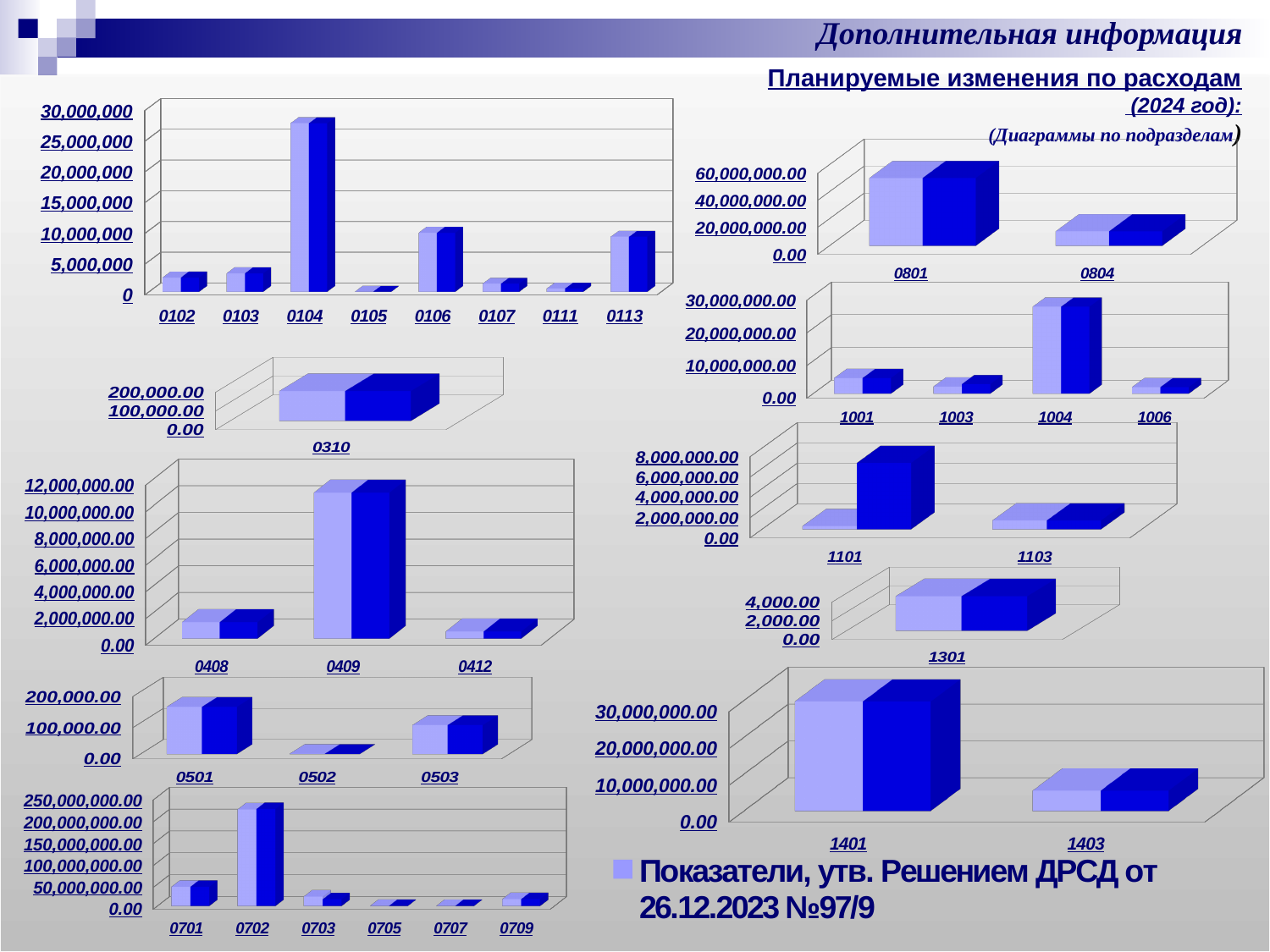
In the chart with categories 1001 to 1006, which category has the highest value? 1004 In the top-left chart (categories 0102 to 0113), which category has the highest value? 0104 In the chart with categories 0701 to 0709, is the value for 0702 greater or less than 200,000,000.00? greater In the chart with categories 0501, 0502 and 0503, which category has the lowest value? 0502 In the chart with categories 0408, 0409 and 0412, which category has the highest value? 0409 In the top-left chart (categories 0102 to 0113), is the value for 0104 greater or less than 25,000,000? greater In the chart with categories 0408, 0409 and 0412, which category has the lowest value? 0412 In the top-left chart (categories 0102 to 0113), how many categories are shown on the x axis? 8 In the chart with categories 1401 and 1403, which category has the larger value? 1401 In the chart with categories 0801 and 0804, which category has the larger value? 0801 What kind of chart is used for the diagrams on this slide? Bar chart